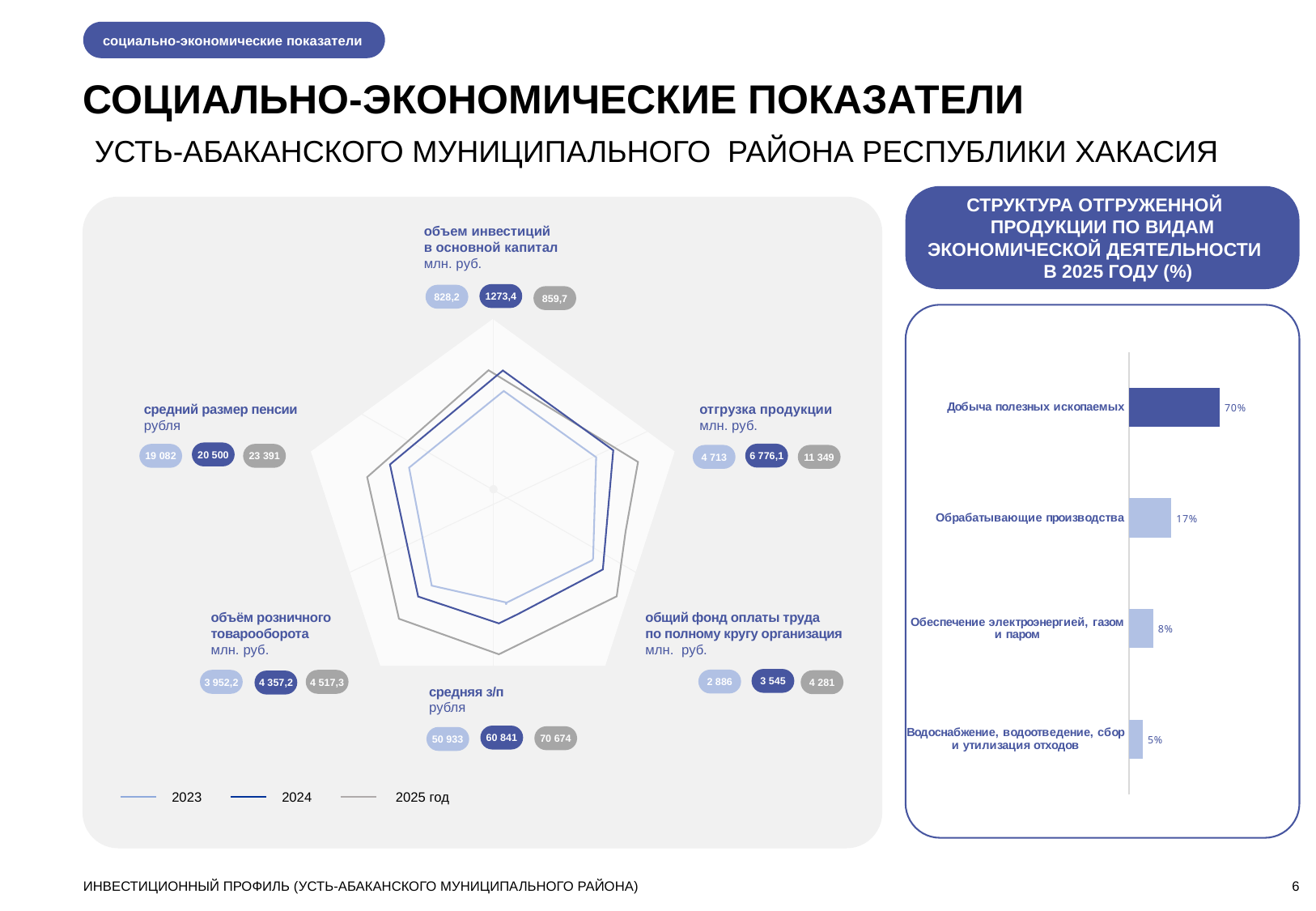
In the radar chart on the left, what is the value of 'средняя з/п' for 2025? 70 674 In the bar chart 'Структура отгруженной продукции по видам экономической деятельности в 2025 году (%)', what is the value for 'Добыча полезных ископаемых'? 70% In the radar chart on the left, which is larger: 'объем инвестиций в основной капитал' in 2024 or in 2025? 2024 In the bar chart on the right, which category has the lowest value? Водоснабжение, водоотведение, сбор и утилизация отходов In the radar chart on the left, what is the value of 'отгрузка продукции' for 2024? 6 776,1 What kind of chart is shown on the right side of the slide? Bar chart In the bar chart on the right, what is the difference between 'Обрабатывающие производства' and 'Обеспечение электроэнергией, газом и паром'? 9% In the bar chart on the right, how many categories are shown? 4 What kind of chart is shown on the left side of the slide? Radar chart In the radar chart on the left, how many indicators (axes) are shown? 6 In the radar chart on the left, what is the difference between 'средний размер пенсии' in 2025 and in 2023? 4 309 In the radar chart on the left, how many series does the legend list? 3